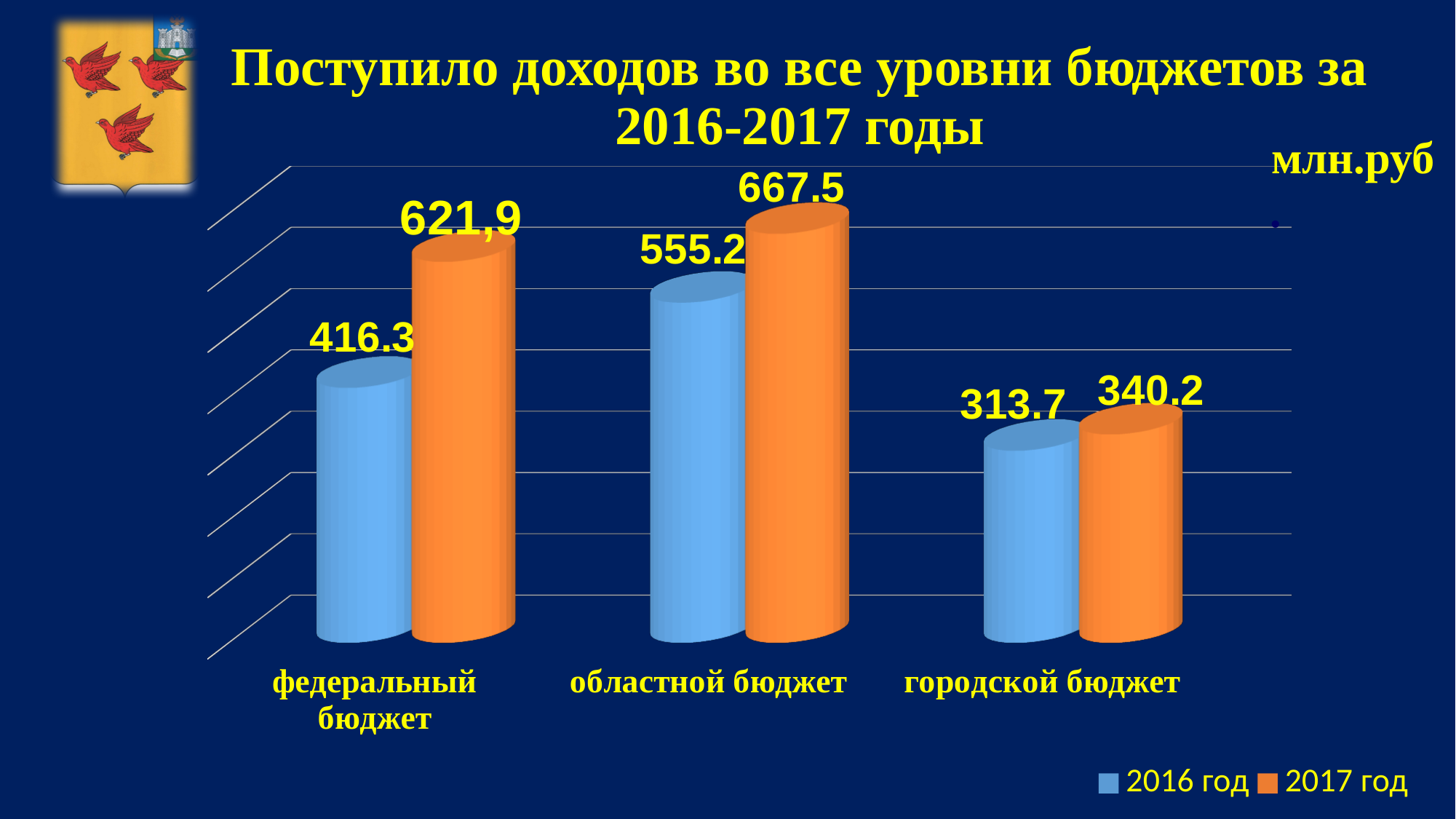
What is the value for федеральный бюджет in 2016 год? 416.3 What is the difference between the 2017 год and 2016 год values for областной бюджет? 112.3 How many categories are shown on the x axis? 3 How many series does the legend list? 2 What kind of chart is shown on the slide? bar chart What is the value for областной бюджет in 2017 год? 667.5 What is the value for городской бюджет in 2016 год? 313.7 What is the value for федеральный бюджет in 2017 год? 621,9 What is the difference between the 2017 год and 2016 год values for городской бюджет? 26.5 Which category has the highest value in 2017 год? областной бюджет Which is larger: the 2016 год value for областной бюджет or the 2017 год value for федеральный бюджет? 2017 год value for федеральный бюджет Which category has the lowest value in 2016 год? городской бюджет